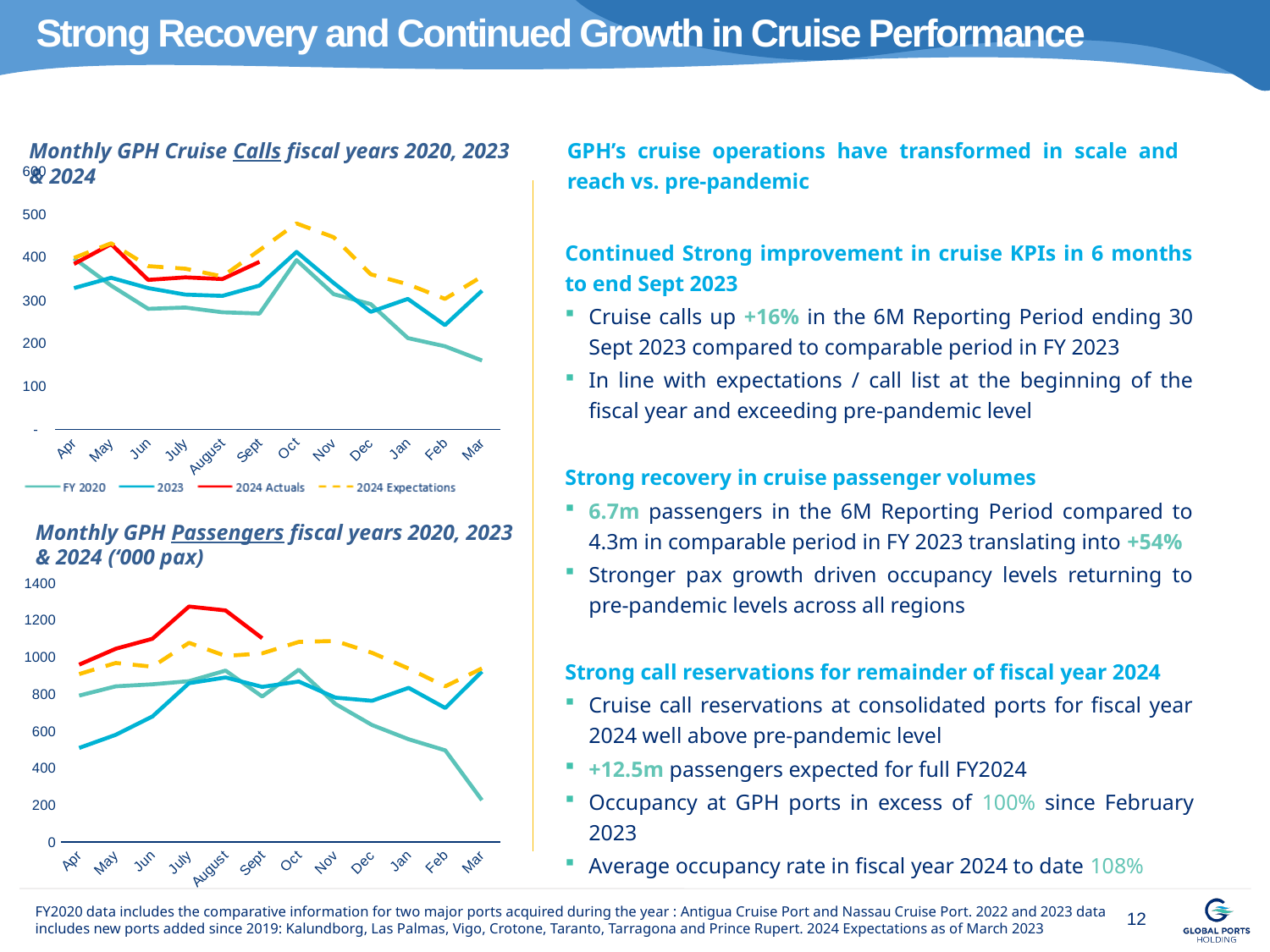
In the 'Monthly GPH Passengers' chart, does the FY 2020 line rise or fall from Oct to Mar? fall In the 'Monthly GPH Cruise Calls' chart, in which month does the 2024 Expectations series reach its highest value? Oct How many months are plotted along the x axis of the 'Monthly GPH Cruise Calls' chart? 12 In the 'Monthly GPH Cruise Calls' chart, is the FY 2020 value for Mar greater or less than 200? less What unit is given in the title of the 'Monthly GPH Passengers' chart at the bottom left? '000 pax In the 'Monthly GPH Cruise Calls' chart, which series is drawn as a dashed yellow line? 2024 Expectations In the 'Monthly GPH Passengers' chart, is the 2024 Actuals value for July greater or less than 1200? greater How many series does the legend of the 'Monthly GPH Cruise Calls' chart list? 4 In the 'Monthly GPH Cruise Calls' chart, which is larger in Oct: the 2024 Expectations value or the 2023 value? 2024 Expectations What kind of chart is the 'Monthly GPH Cruise Calls' chart at the top left of the slide? Line chart In the 'Monthly GPH Passengers' chart, in which month does the red 2024 Actuals line reach its highest value? July In the 'Monthly GPH Cruise Calls' chart, is the 2024 Expectations value for Oct greater or less than 400? greater